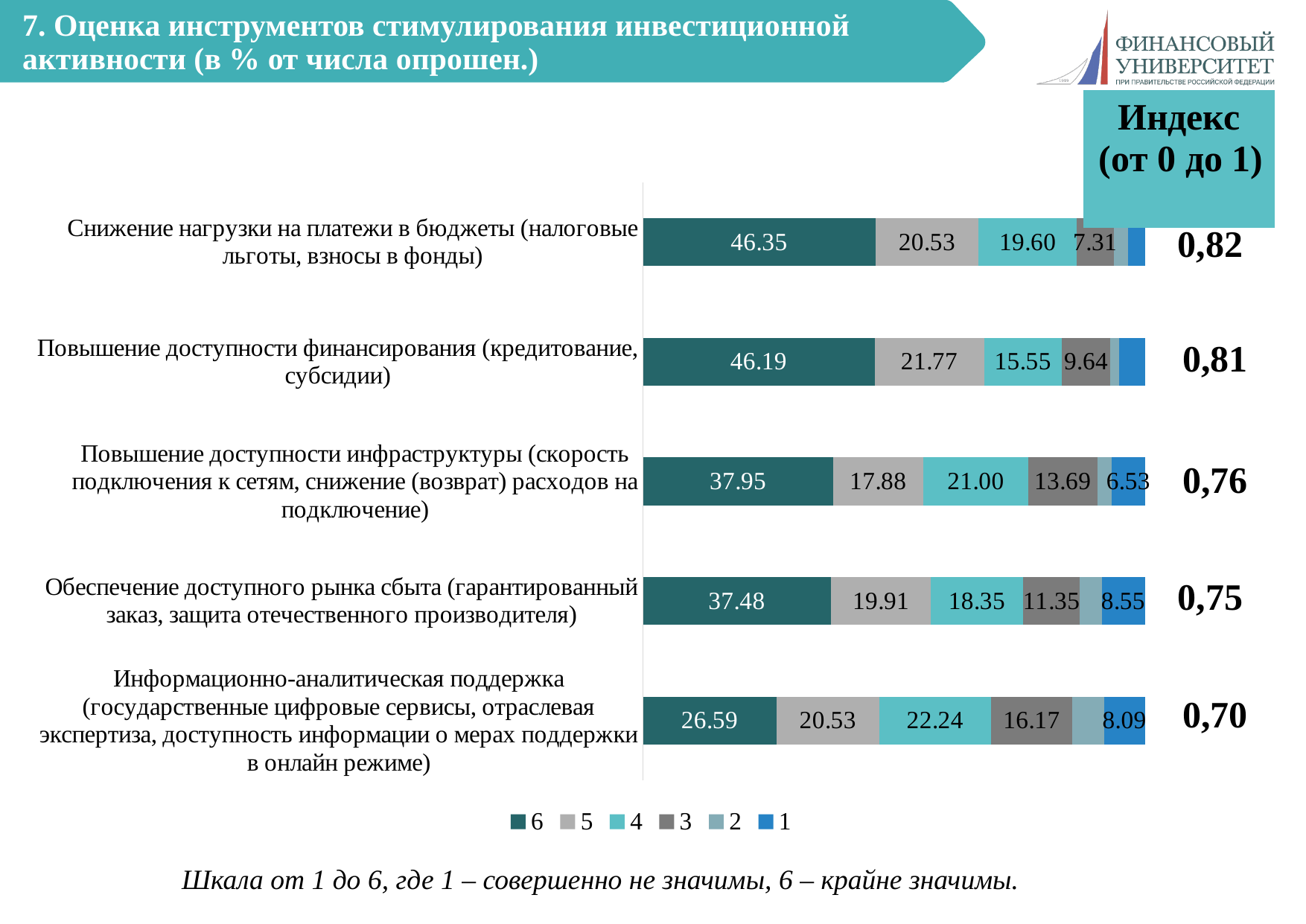
What is the value of series 3 for «Информационно-аналитическая поддержка»? 16.17 What is the value of series 4 for «Повышение доступности финансирования (кредитование, субсидии)»? 15.55 What is the value of series 6 for «Снижение нагрузки на платежи в бюджеты (налоговые льготы, взносы в фонды)»? 46.35 Which category has the lowest value for series 6? Информационно-аналитическая поддержка Which is larger: the series 5 value for «Повышение доступности финансирования» or the series 5 value for «Повышение доступности инфраструктуры»? Повышение доступности финансирования Which category has the highest value for series 3? Информационно-аналитическая поддержка What is the difference between the series 6 values for «Повышение доступности инфраструктуры» (37.95) and «Обеспечение доступного рынка сбыта» (37.48)? 0.47 How many categories (support instruments) are plotted in the chart? 5 What is the value of series 1 for «Повышение доступности инфраструктуры»? 6.53 How many series does the legend list? 6 What kind of chart is shown on the slide? Stacked bar chart What are the legend entries of the chart, in order? 6, 5, 4, 3, 2, 1